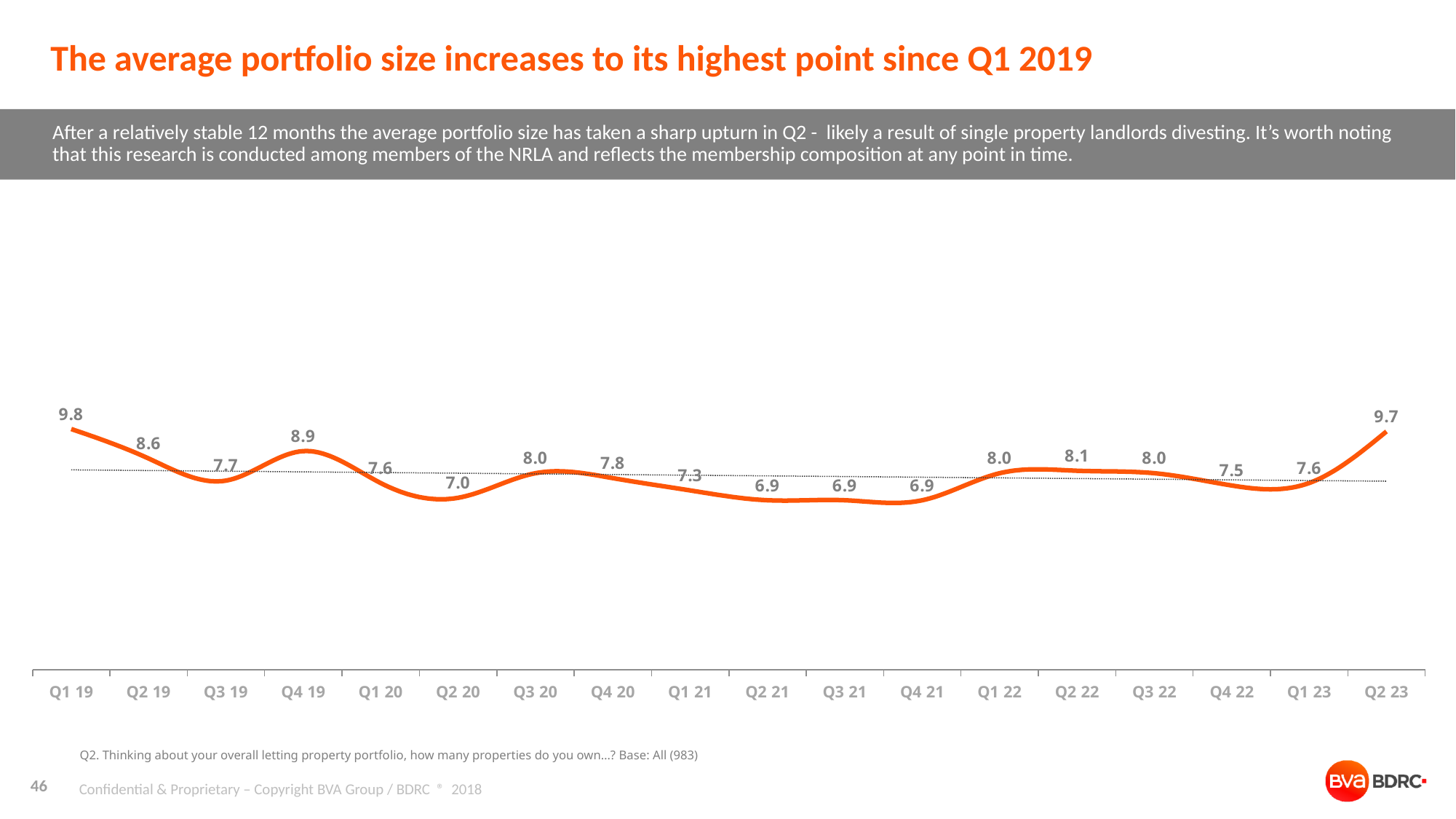
What is the title of the slide? The average portfolio size increases to its highest point since Q1 2019 Which value is the lowest on the chart, and in which quarters does it occur? 6.9, in Q2 21, Q3 21 and Q4 21 What is the difference between the values for Q1 19 and Q2 19? 1.2 Which is larger, the value for Q4 19 or the value for Q2 22? Q4 19 What is the difference between the values for Q2 23 and Q1 23? 2.1 Which quarter has the highest average portfolio size? Q1 19 What is the average portfolio size for Q4 19? 8.9 Do the values rise or fall from Q4 22 to Q2 23? Rise What is the value plotted for Q2 20? 7.0 What is the average portfolio size for Q2 23? 9.7 What kind of chart is shown on the slide? Line chart How many quarters are plotted on the x axis? 18